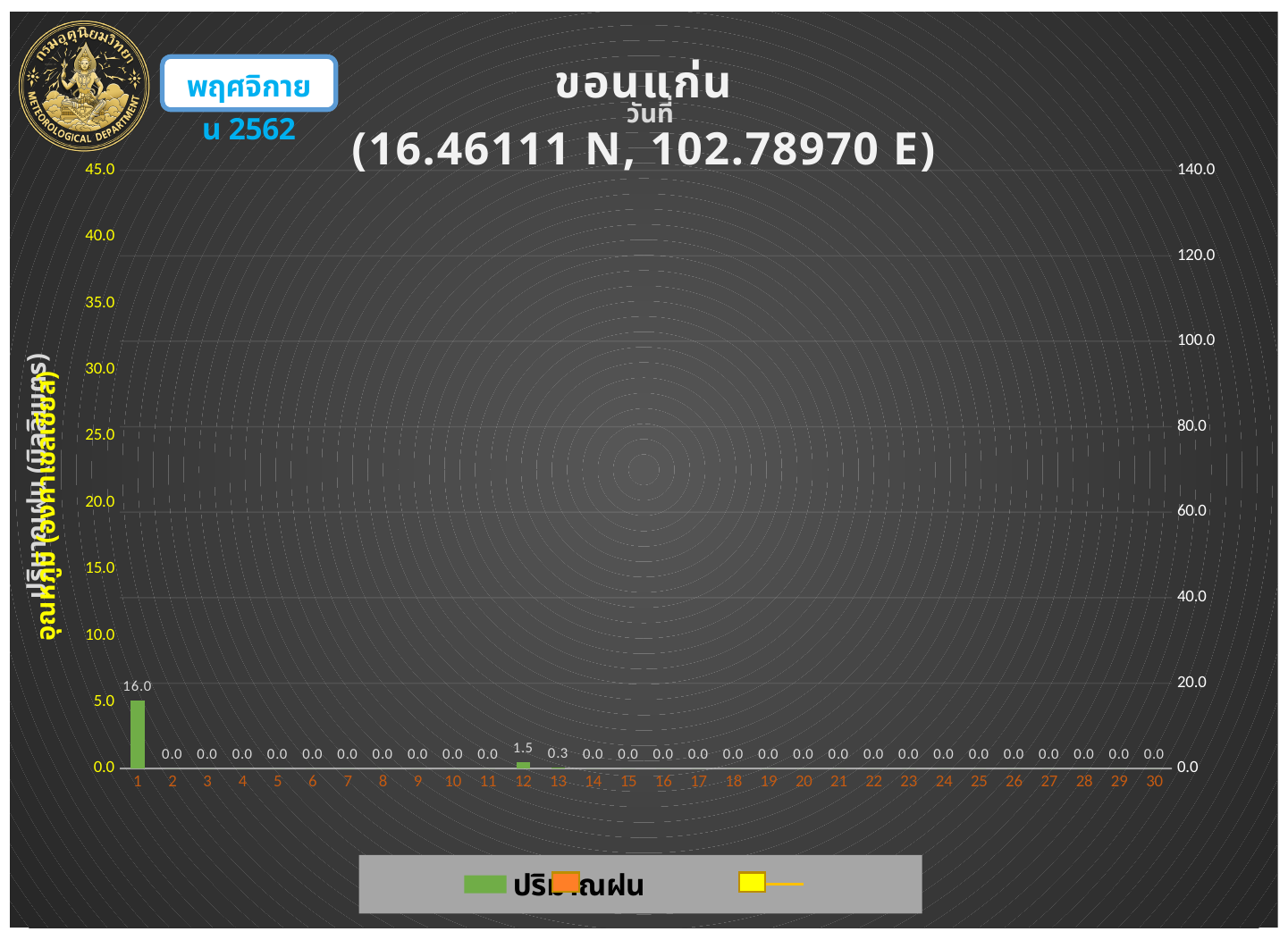
What is the rainfall value shown for day 1? 16.0 Which day has the highest rainfall value? 1 What is the rainfall value shown for day 20? 0.0 What is the rainfall value shown for day 12? 1.5 What is the difference between the rainfall values for day 12 and day 13? 1.2 Which day has the larger rainfall value, day 12 or day 13? 12 What is the rainfall value shown for day 13? 0.3 How many days are shown on the x axis? 30 What is the difference between the rainfall values for day 1 and day 12? 14.5 What coordinates are given in the chart title? 16.46111 N, 102.78970 E What is the highest tick value on the right-hand y axis? 140.0 What kind of chart is shown on the slide? bar chart